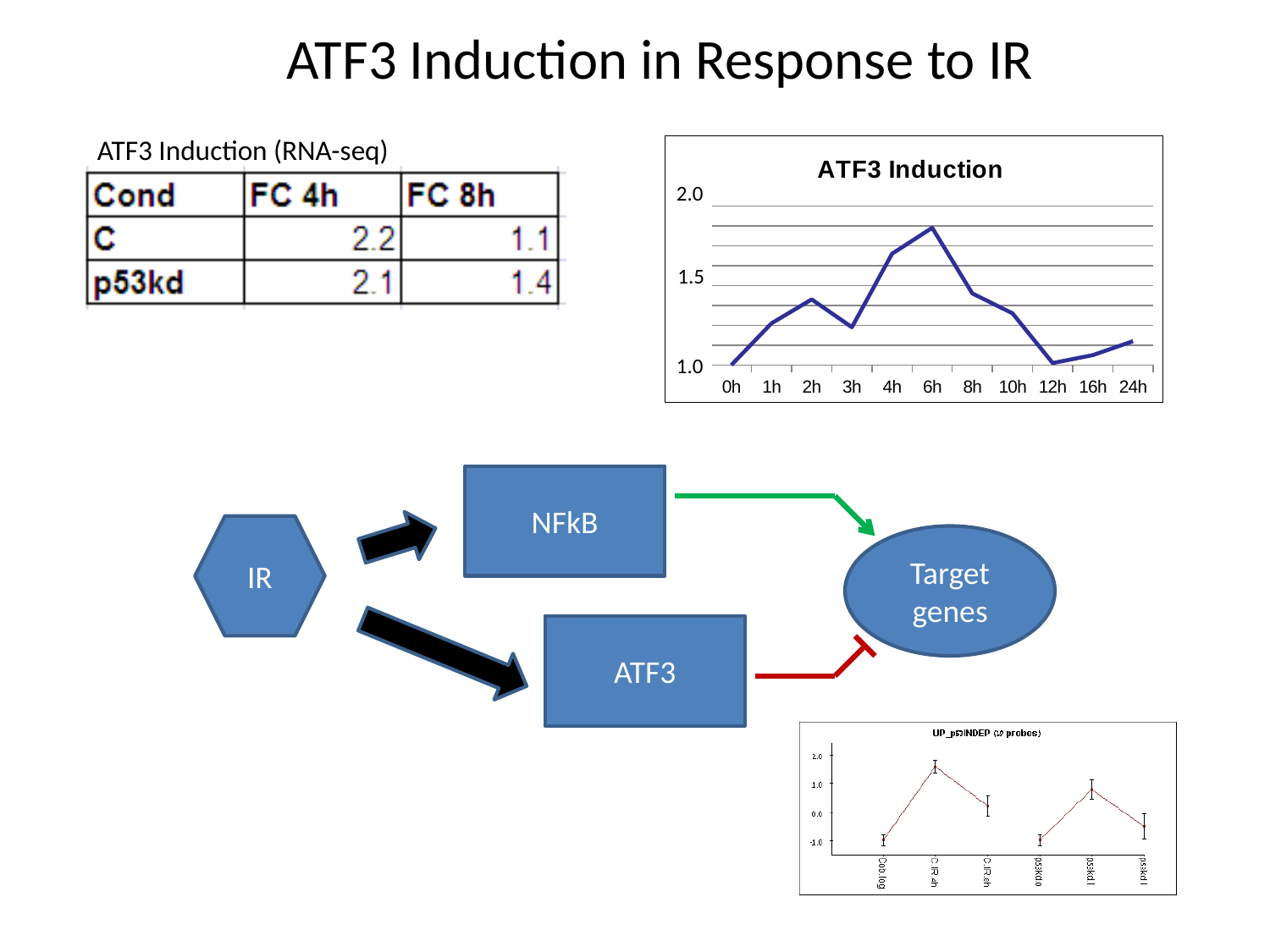
In the ATF3 Induction chart, is the value at 6h greater or less than 1.5? greater In the ATF3 Induction chart, do the values rise or fall between 6h and 12h? fall In the ATF3 Induction chart, do the values rise or fall between 0h and 2h? rise In the ATF3 Induction chart, is the value at 12h greater or less than 1.5? less In the ATF3 Induction chart, is the value at 4h greater or less than 1.5? greater What is the highest value shown on the y axis of the ATF3 Induction chart? 2.0 In the ATF3 Induction chart, what kind of chart is shown? line chart In the ATF3 Induction chart, how many time points are plotted along the x axis? 11 In the ATF3 Induction chart, which has the larger value, 4h or 2h? 4h In the ATF3 Induction chart, at which time point is the value highest? 6h In the ATF3 Induction chart, which has the larger value, 6h or 3h? 6h